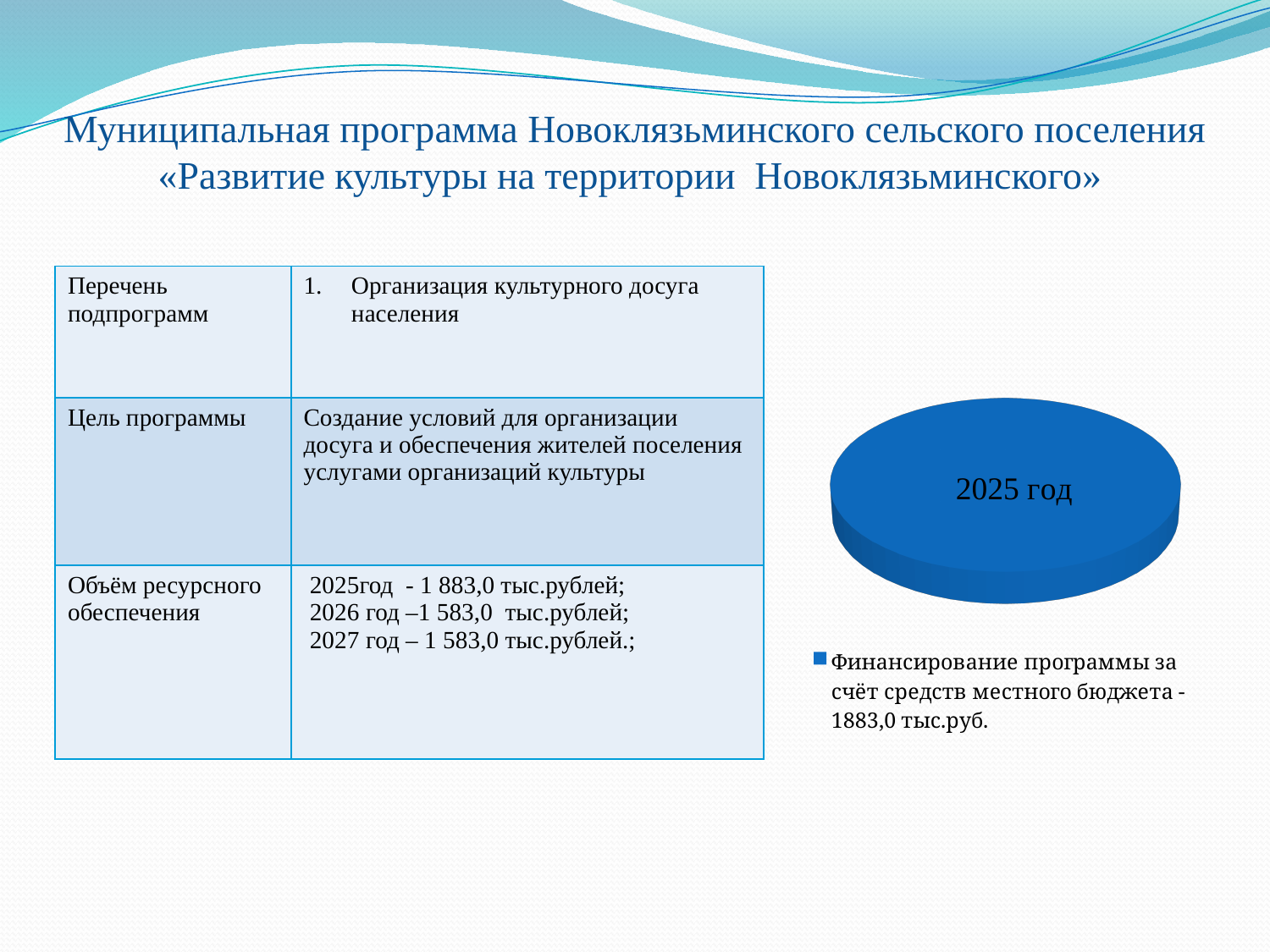
What share of the pie chart does the single slice occupy? 100% What label is printed on the slice of the pie chart? 2025 год What is the legend entry of the pie chart? Финансирование программы за счёт средств местного бюджета - 1883,0 тыс.руб. How many entries does the legend of the pie chart list? 1 How many slices does the pie chart contain? 1 What kind of chart is shown on the right side of the slide? pie chart According to the legend of the pie chart, what is the amount of programme financing from the local budget? 1883,0 тыс.руб. Is the value shown in the pie chart legend (1883,0 тыс.руб.) greater or less than 1500? greater